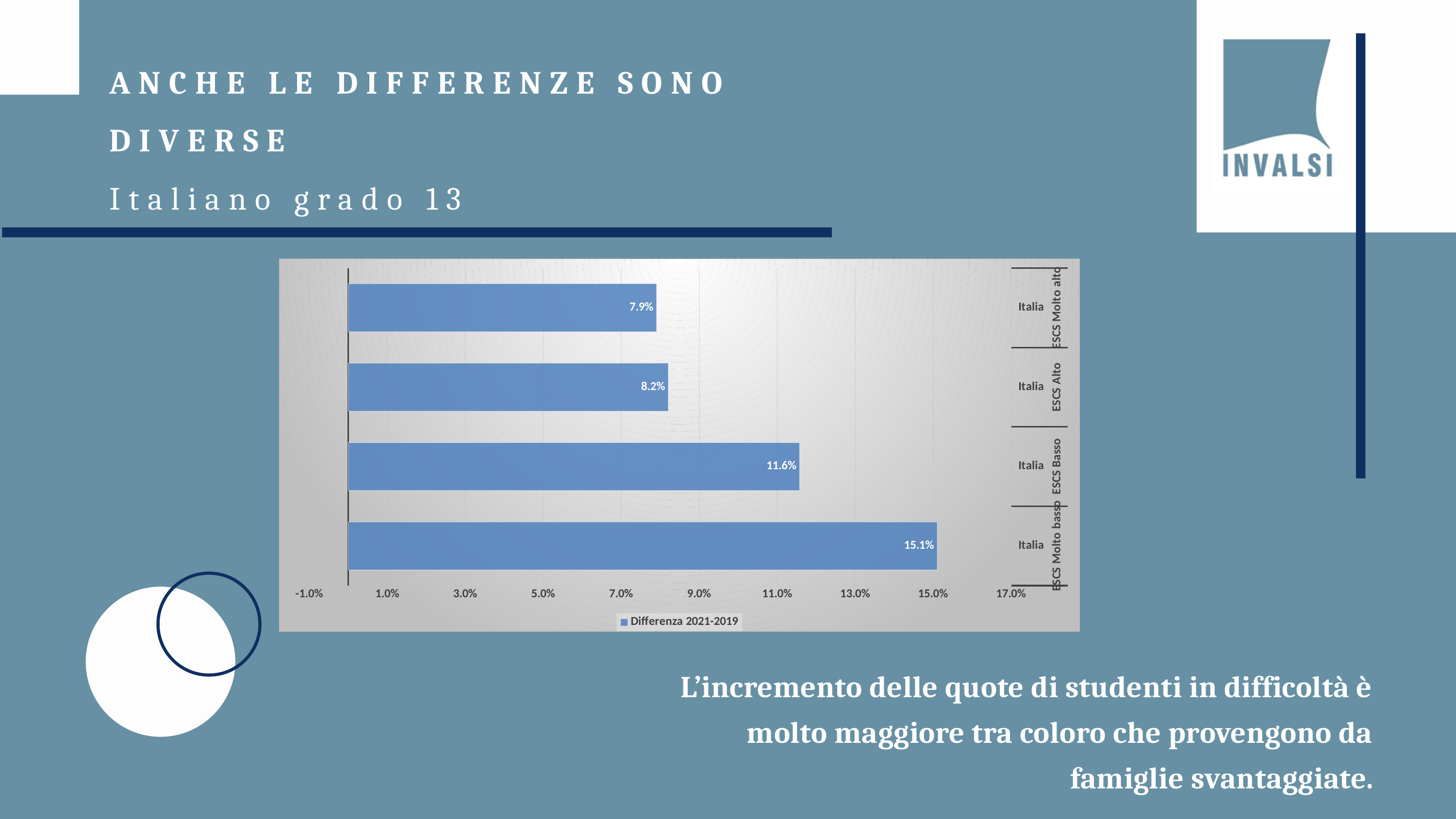
What series name does the legend show? Differenza 2021-2019 What is the value for ESCS Molto basso? 15.1% What is the difference between the values for ESCS Molto basso and ESCS Molto alto? 7.2% What is the value for ESCS Molto alto? 7.9% How many categories are shown in the chart? 4 Is the value for ESCS Basso greater or less than 9.0%? greater What is the value for ESCS Alto? 8.2% What kind of chart is shown on the slide? bar chart What is the value for ESCS Basso? 11.6% Which is larger, the value for ESCS Basso or the value for ESCS Alto? ESCS Basso Which category has the lowest value? ESCS Molto alto Which category has the highest value? ESCS Molto basso